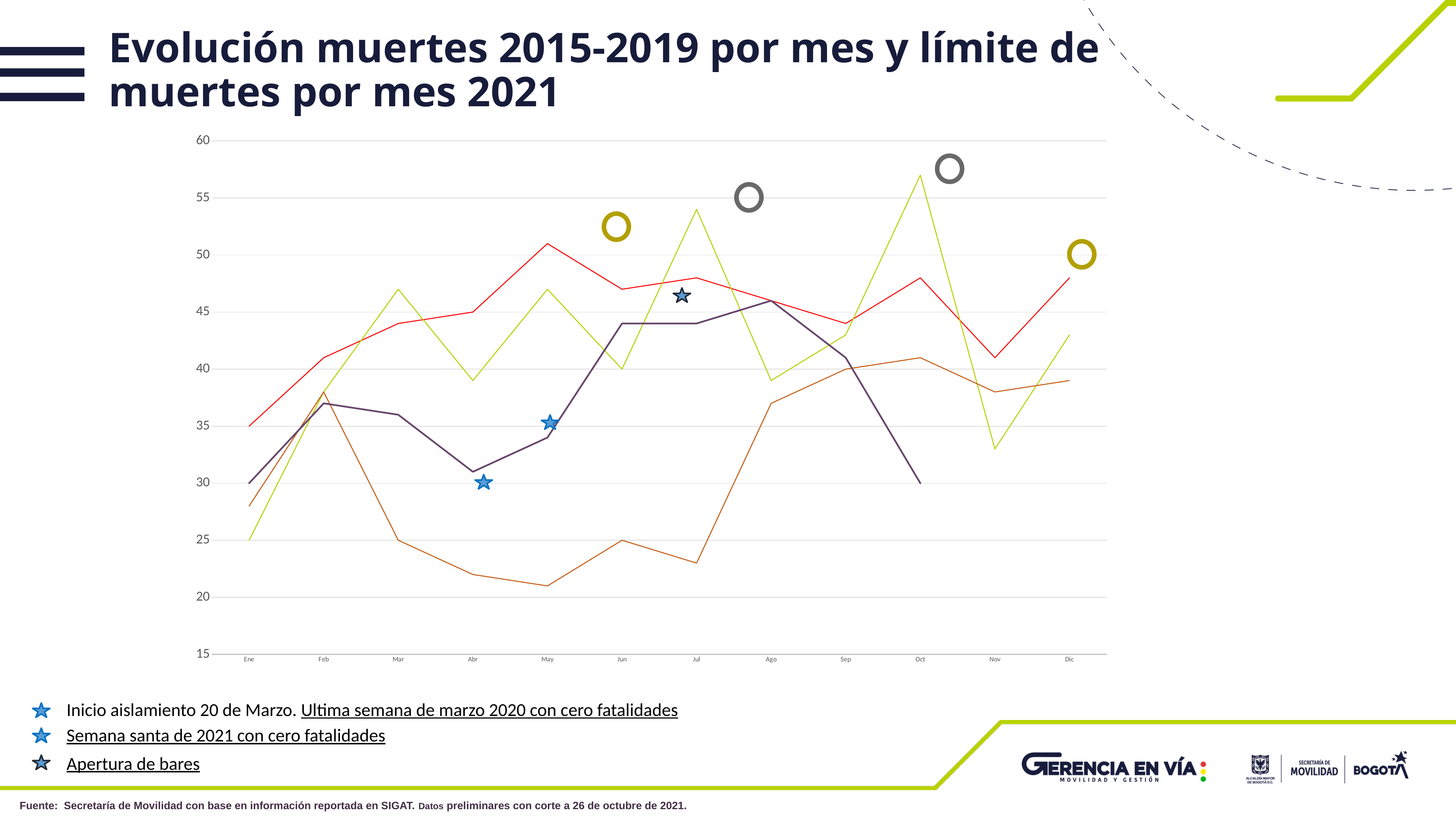
Is the value of the orange line at May greater or less than 25? less At Ene, which line has the larger value, the red line or the orange line? red line What is the title of the chart on the slide? Evolución muertes 2015-2019 por mes y límite de muertes por mes 2021 What kind of chart is shown on the slide? line chart Is the value of the red line at Ene greater or less than 40? less Is the value of the yellow-green line at Oct greater or less than 55? greater In which month does the yellow-green line have its lowest value? Ene In which month does the yellow-green line reach its highest value? Oct Does the orange line rise or fall from Feb to May? fall How many months are shown along the x axis of the chart? 12